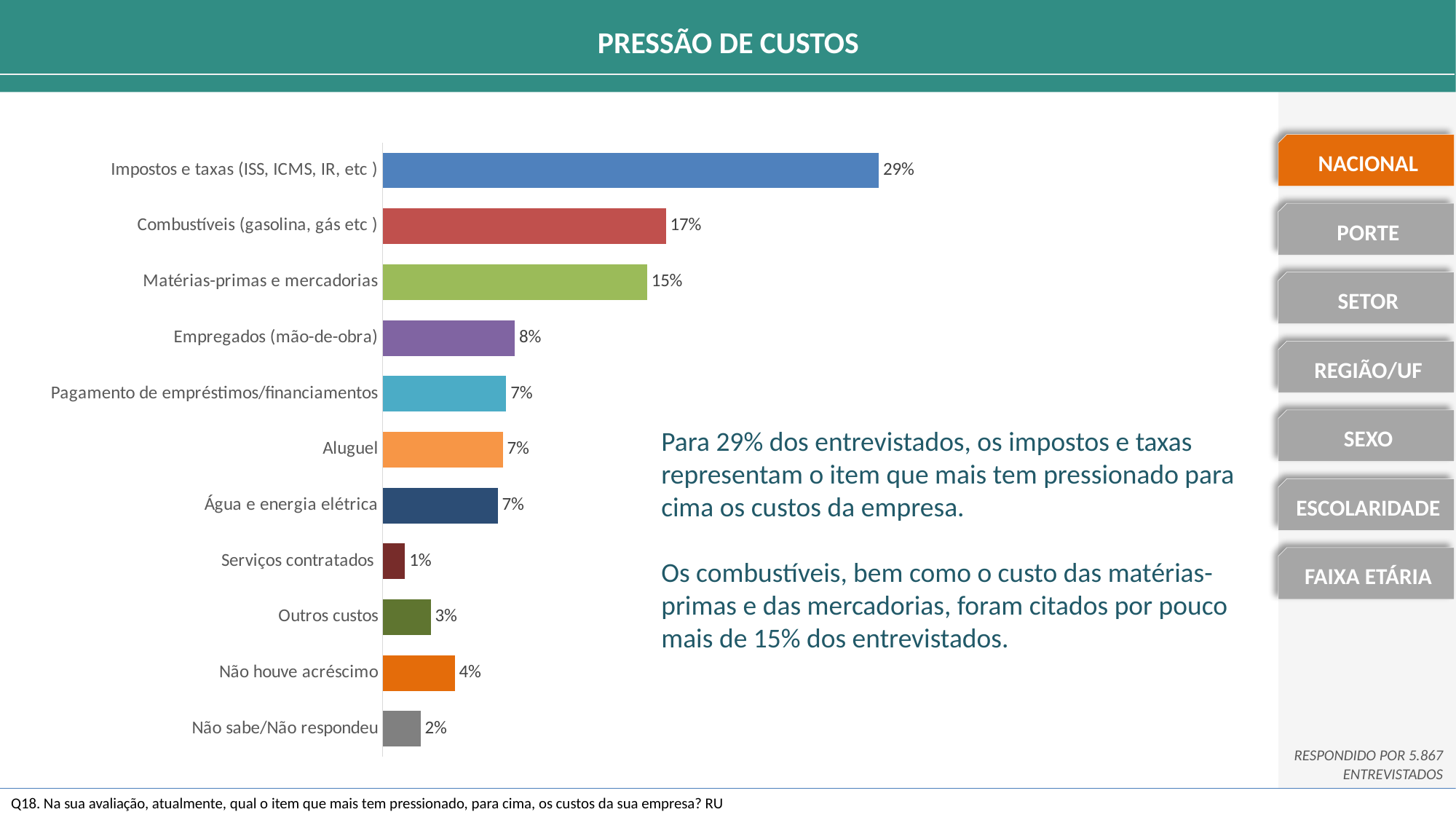
What is the title of the slide containing the chart? PRESSÃO DE CUSTOS Which is larger, the value for Não houve acréscimo or the value for Não sabe/Não respondeu? Não houve acréscimo What is the value for Matérias-primas e mercadorias? 15% Which category has the highest value? Impostos e taxas (ISS, ICMS, IR, etc ) What is the value for Impostos e taxas (ISS, ICMS, IR, etc )? 29% What is the difference between the values for Empregados (mão-de-obra) and Outros custos? 5% What kind of chart is shown on the slide? Bar chart What is the value for Não houve acréscimo? 4% How many categories are shown in the chart? 11 What is the value for Combustíveis (gasolina, gás etc )? 17% What is the difference between the values for Impostos e taxas (ISS, ICMS, IR, etc ) and Combustíveis (gasolina, gás etc )? 12% Which category has the lowest value? Serviços contratados